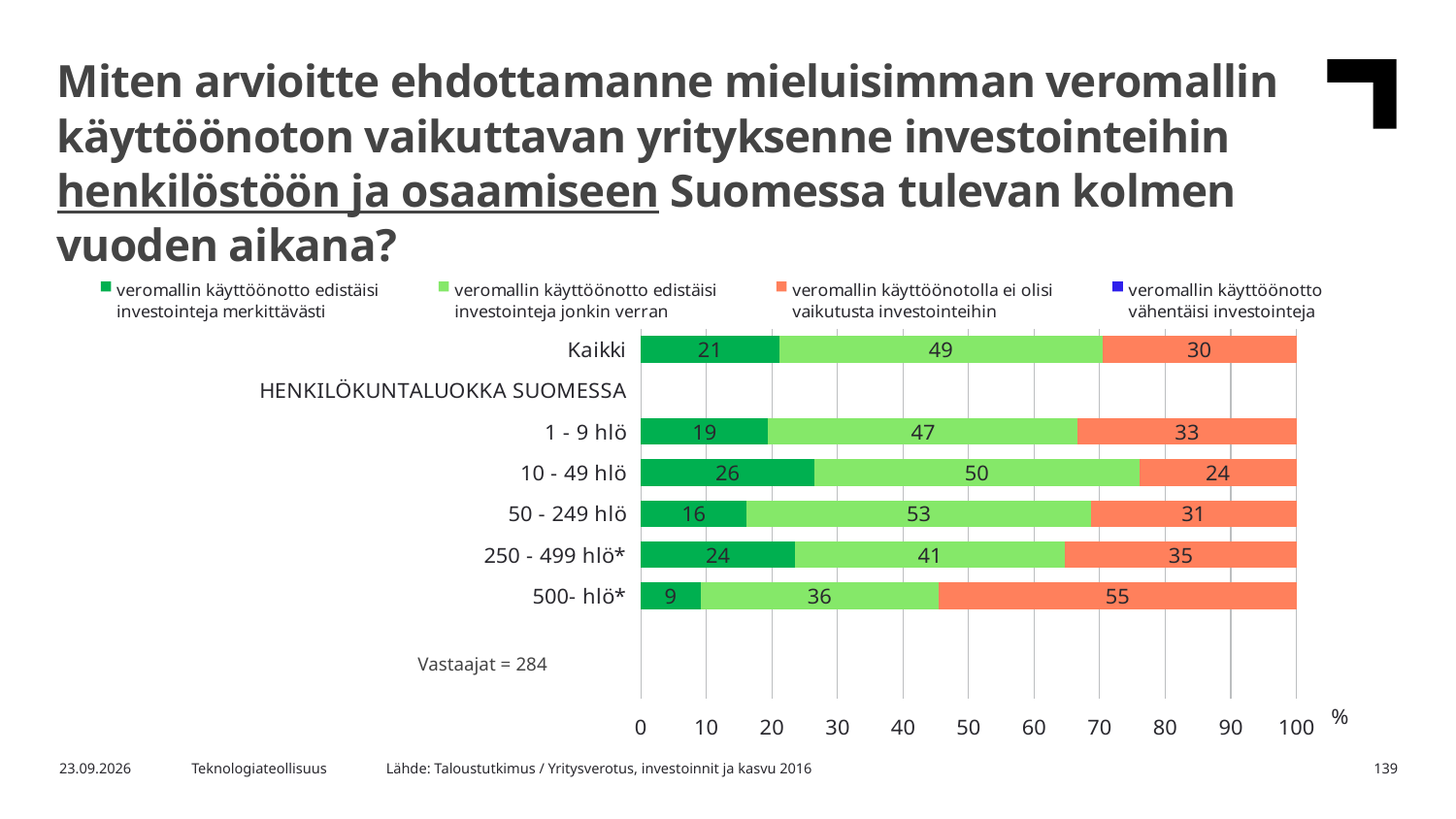
How many bars with data are plotted in the chart? 6 Which category has the lowest value for 'veromallin käyttöönotto edistäisi investointeja jonkin verran'? 500- hlö* Which category has the highest value for 'veromallin käyttöönotto edistäisi investointeja merkittävästi'? 10 - 49 hlö What is the value for 'veromallin käyttöönotolla ei olisi vaikutusta investointeihin' for 500- hlö*? 55 What is the value for 'veromallin käyttöönotto edistäisi investointeja merkittävästi' in the Kaikki bar? 21 What kind of chart is shown on the slide? stacked bar chart What is the difference between the 'veromallin käyttöönotolla ei olisi vaikutusta investointeihin' values for 500- hlö* and 10 - 49 hlö? 31 What is the value for 'veromallin käyttöönotto edistäisi investointeja jonkin verran' for 50 - 249 hlö? 53 How many series does the legend list? 4 How many respondents (Vastaajat) are stated on the slide? 284 What is the total of the stacked bar for 1 - 9 hlö? 99 Which is larger: the 'veromallin käyttöönotto edistäisi investointeja merkittävästi' value for 250 - 499 hlö* or for 1 - 9 hlö? 250 - 499 hlö*